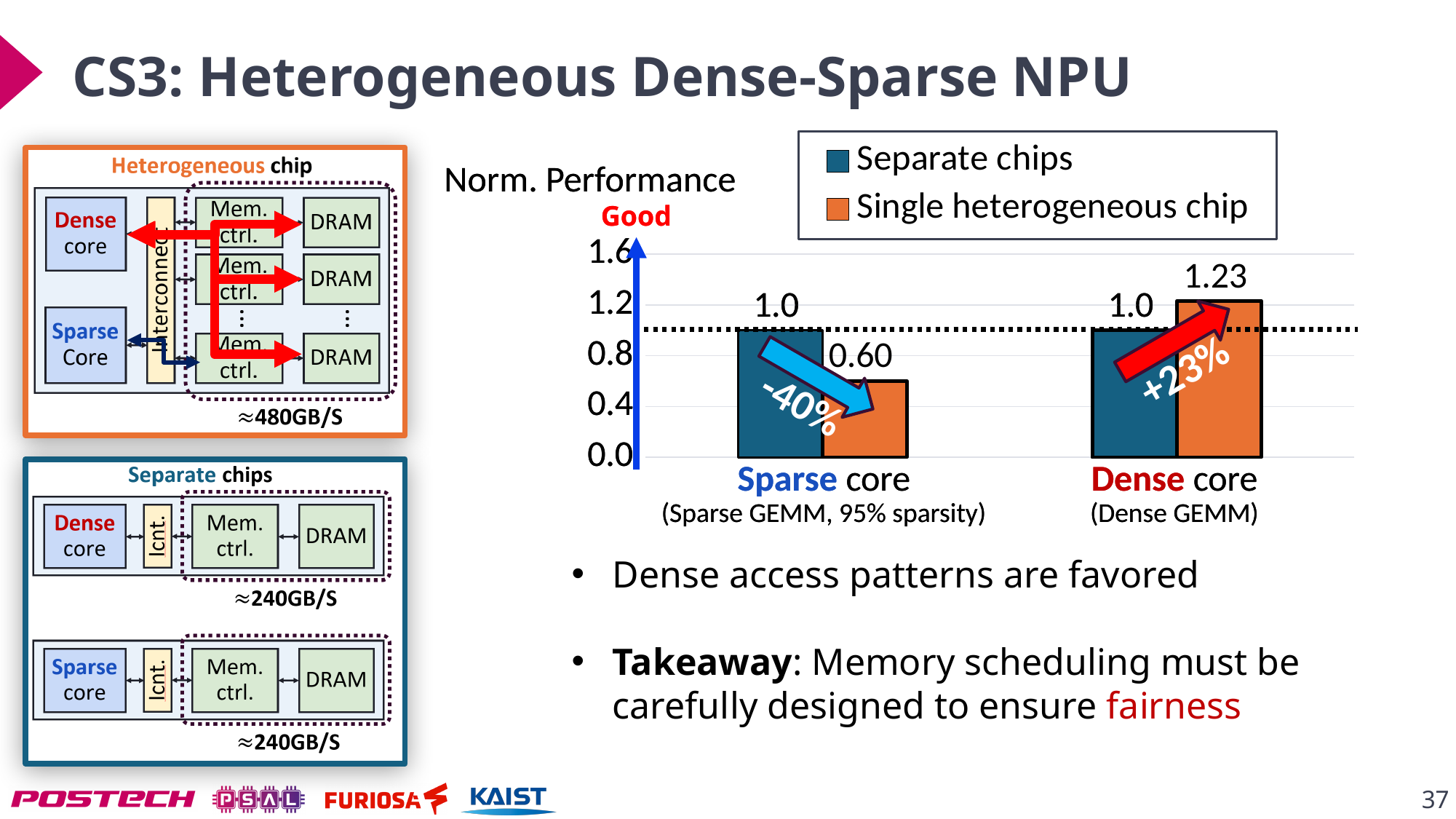
What is the normalized performance of the Single heterogeneous chip for the Sparse core? 0.60 For the Sparse core, which is larger: Separate chips or Single heterogeneous chip? Separate chips Which category has the lowest value for the Single heterogeneous chip series? Sparse core What kind of chart is shown on the slide? Bar chart Is the Single heterogeneous chip value for the Dense core greater or less than 1.2? greater What is the normalized performance of Separate chips for the Dense core? 1.0 What is the difference between the Single heterogeneous chip value and the Separate chips value for the Dense core? 0.23 What is the difference between the Separate chips value and the Single heterogeneous chip value for the Sparse core? 0.40 How many categories are shown on the x axis of the chart? 2 What is the normalized performance of the Single heterogeneous chip for the Dense core? 1.23 Which category has the highest value for the Single heterogeneous chip series? Dense core How many series does the chart legend list? 2